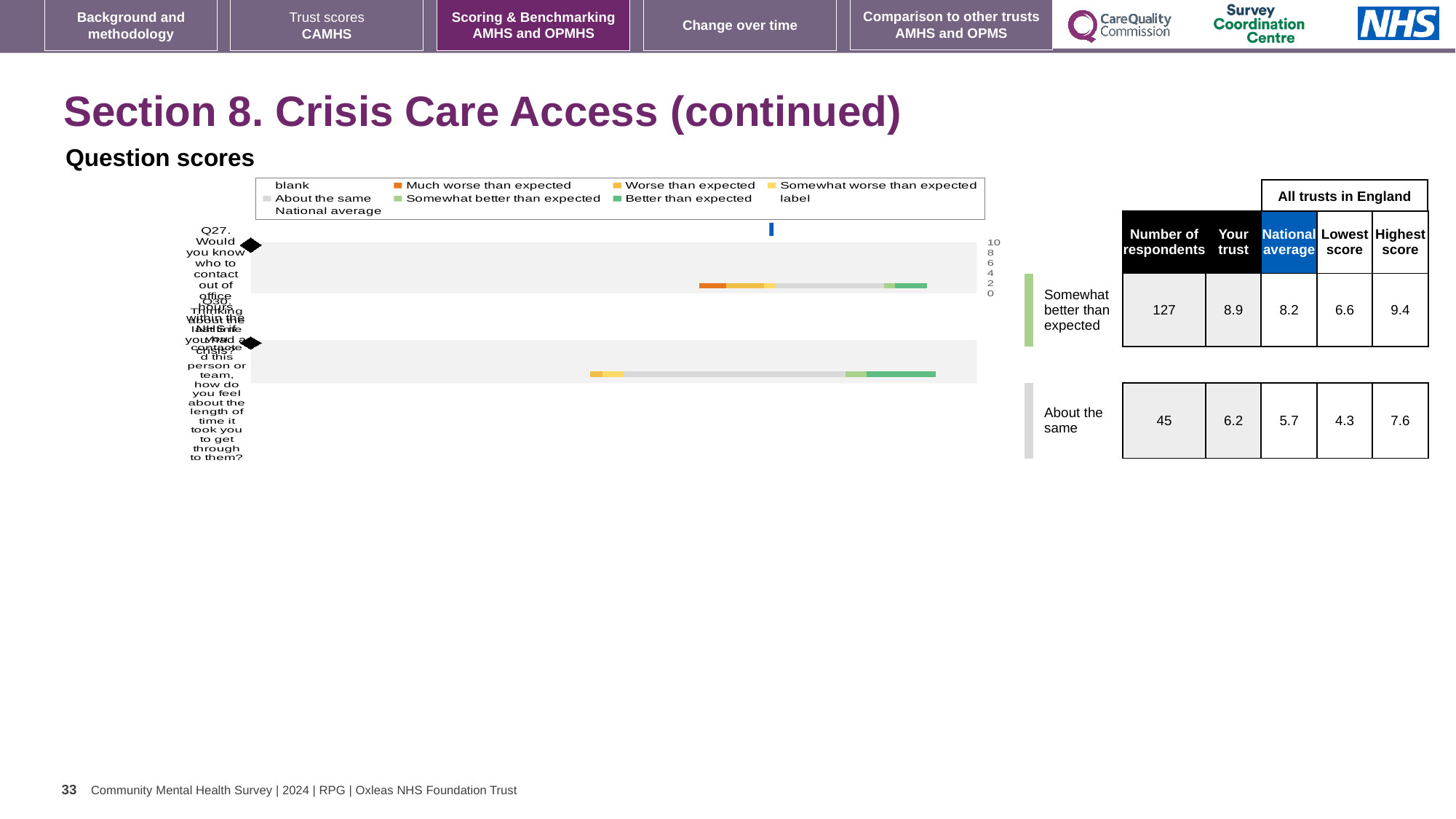
In the table beside the chart, for the 'About the same' row, which is larger: the 'Your trust' score or the national average? Your trust In the table beside the chart, what is the 'Your trust' score for the question rated 'Somewhat better than expected'? 8.9 In the table beside the chart, what is the national average for the question rated 'About the same'? 5.7 How many question bars are plotted in the chart? 2 How many entries does the chart legend list? 9 In the table beside the chart, how many respondents answered the question rated 'Somewhat better than expected'? 127 What kind of chart is shown under 'Question scores'? bar chart What is the first legend entry listed in the chart legend? blank In the table beside the chart, what is the highest score among all trusts in England for the question rated 'About the same'? 7.6 Which legend entry is shown in orange? Much worse than expected In the table beside the chart, what is the lowest score among all trusts in England for the 'Somewhat better than expected' row? 6.6 In the table beside the chart, what is the difference in number of respondents between the 'Somewhat better than expected' row (127) and the 'About the same' row (45)? 82